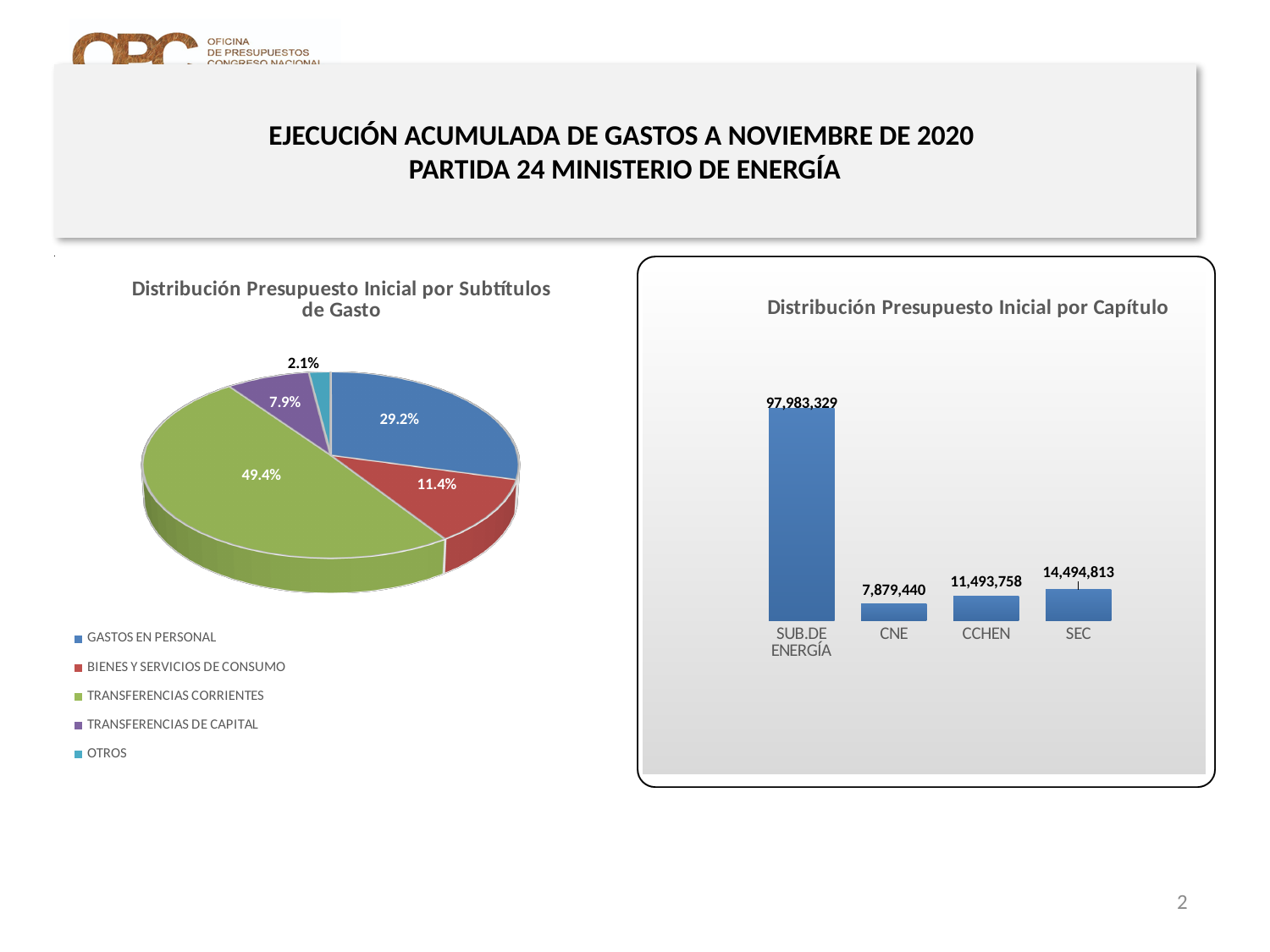
In the 'Distribución Presupuesto Inicial por Capítulo' chart, what is the difference between the values for SEC and CCHEN? 3,001,055 In the 'Distribución Presupuesto Inicial por Capítulo' chart, what is the value for CCHEN? 11,493,758 In the 'Distribución Presupuesto Inicial por Subtítulos de Gasto' pie chart, what share does TRANSFERENCIAS CORRIENTES have? 49.4% In the 'Distribución Presupuesto Inicial por Capítulo' chart, what is the value for SUB.DE ENERGÍA? 97,983,329 In the 'Distribución Presupuesto Inicial por Capítulo' chart, which category has the lowest value? CNE In the 'Distribución Presupuesto Inicial por Capítulo' chart, which category has the highest value? SUB.DE ENERGÍA In the 'Distribución Presupuesto Inicial por Capítulo' chart, how many categories are shown? 4 How many entries does the legend of the 'Distribución Presupuesto Inicial por Subtítulos de Gasto' pie chart list? 5 In the 'Distribución Presupuesto Inicial por Capítulo' chart, what is the value for CNE? 7,879,440 In the 'Distribución Presupuesto Inicial por Subtítulos de Gasto' pie chart, which category has the smallest slice? OTROS In the 'Distribución Presupuesto Inicial por Subtítulos de Gasto' pie chart, what share does GASTOS EN PERSONAL have? 29.2% What kind of chart is 'Distribución Presupuesto Inicial por Capítulo'? Bar chart